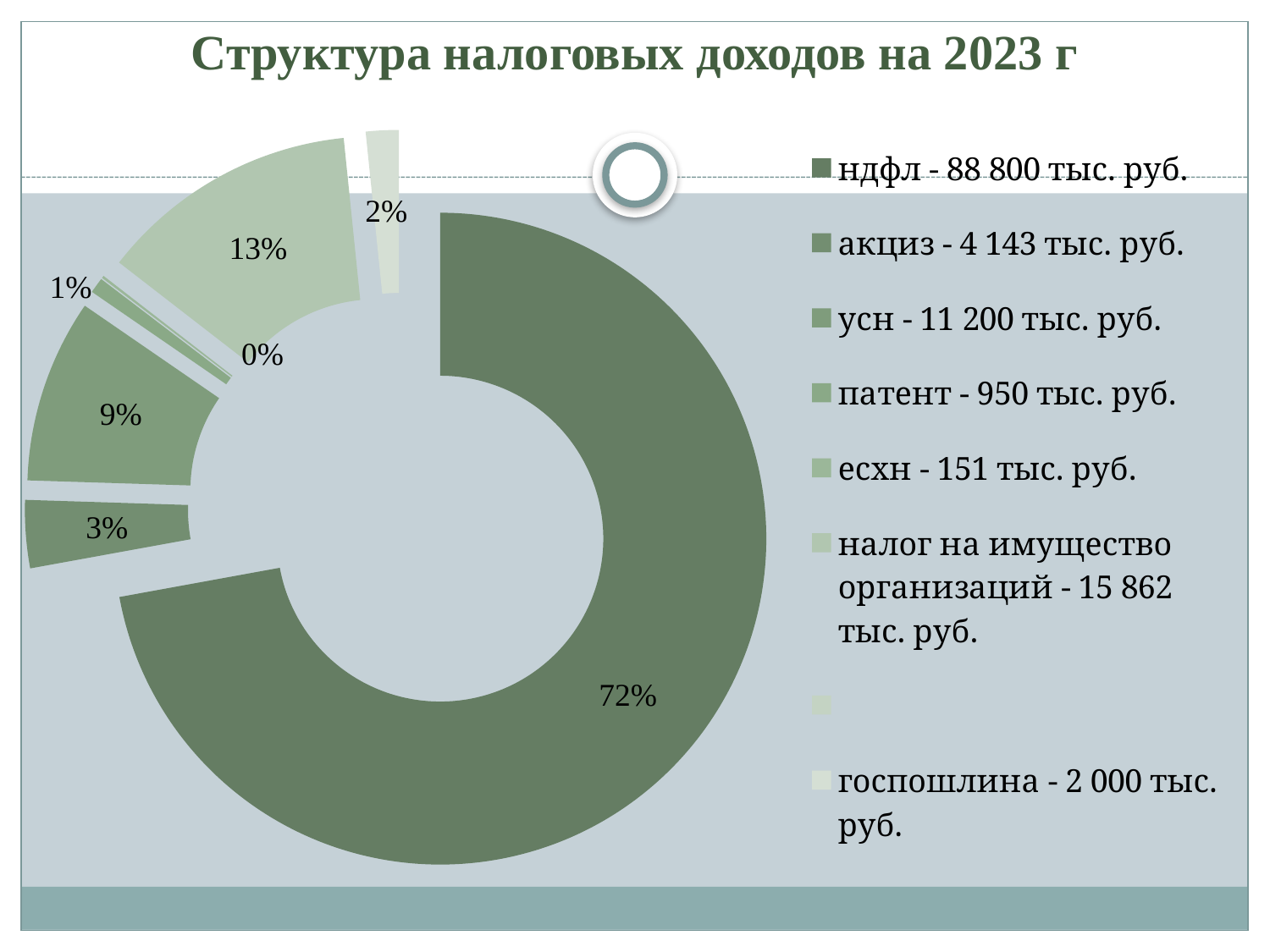
Which has a larger share: усн or акциз? усн What share of tax revenue does госпошлина account for? 2% According to the legend, what is the amount for патент? 950 тыс. руб. What share of tax revenue does налог на имущество организаций account for? 13% Which category has the smallest share of tax revenue? есхн What is the title of the chart? Структура налоговых доходов на 2023 г What share of tax revenue does усн account for? 9% Which category has the largest share of tax revenue? ндфл What is the difference in percentage points between the shares of ндфл and налог на имущество организаций? 59 percentage points According to the legend, what is the amount for акциз? 4 143 тыс. руб. What kind of chart is shown on the slide? doughnut (pie) chart